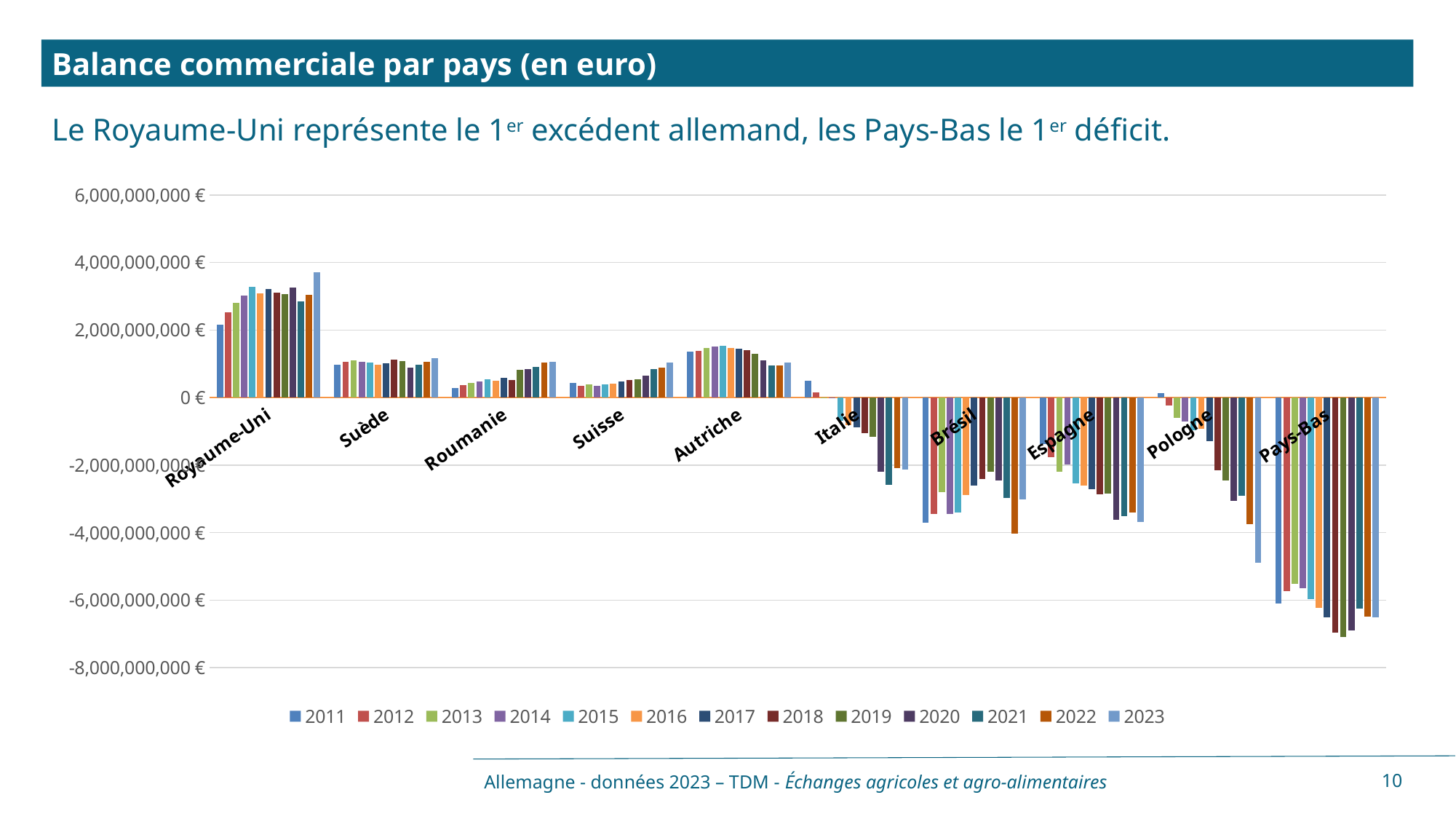
What is the title of the chart? Balance commerciale par pays (en euro) Which years does the legend cover, from first to last? 2011 to 2023 Which country has the highest value for 2023? Royaume-Uni For Royaume-Uni, which year has the highest value? 2023 Is the value for Pays-Bas in 2023 greater or less than -6,000,000,000 €? less What kind of chart is shown on the slide? bar chart How many series does the legend list? 13 Which country has the lowest value for 2023? Pays-Bas Which is larger, the 2023 value for Royaume-Uni or the 2023 value for Suède? Royaume-Uni How many countries are shown on the x axis? 10 Is the value for Brésil in 2022 greater or less than -2,000,000,000 €? less Is the value for Royaume-Uni in 2023 greater or less than 2,000,000,000 €? greater